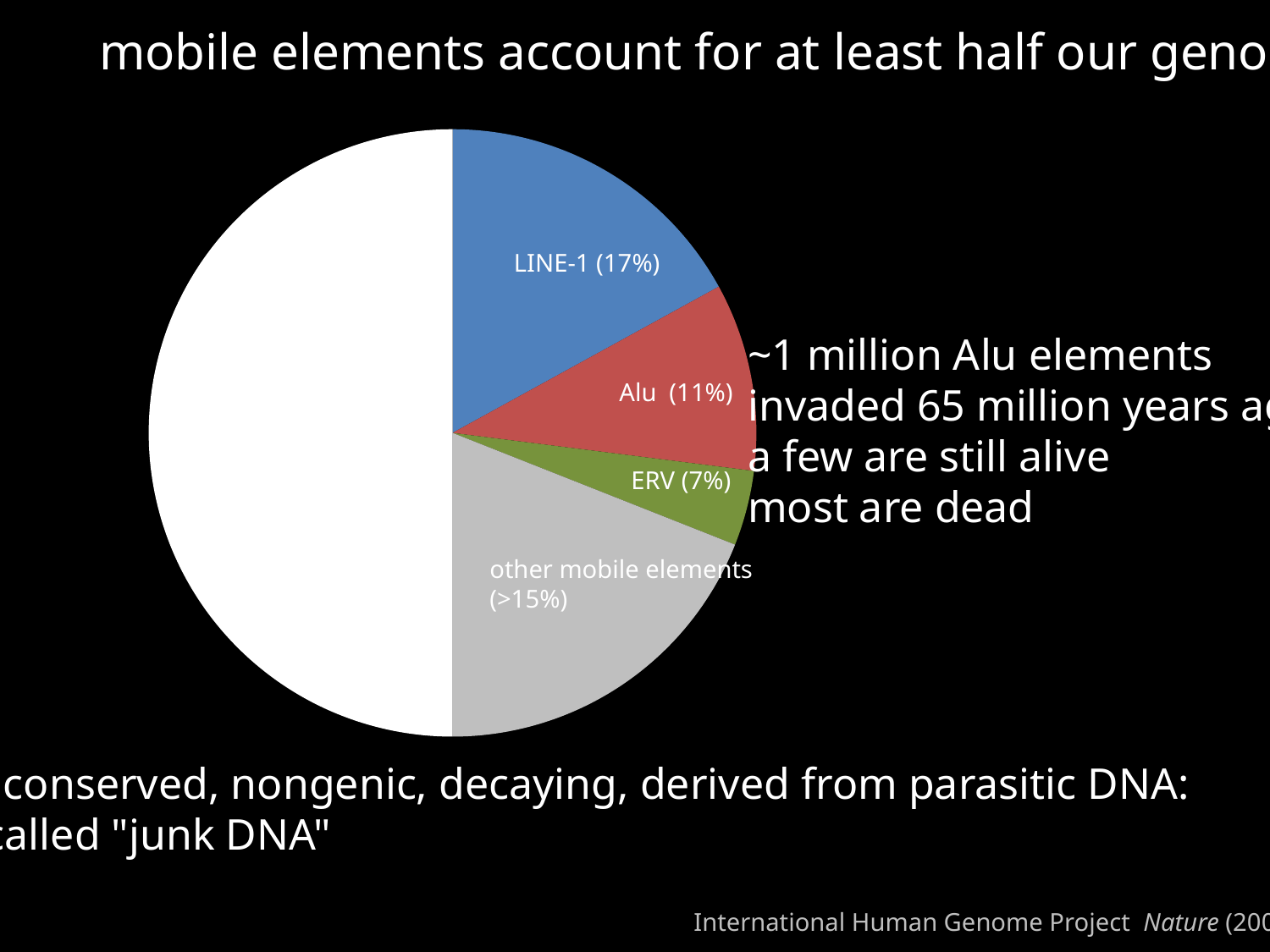
How many slices of the pie chart have a text label? 4 What percentage is given for other mobile elements in the pie chart? >15% Among LINE-1, Alu and ERV, which slice has the smallest percentage? ERV Which is larger, the LINE-1 slice or the Alu slice? LINE-1 What colour is the LINE-1 slice in the pie chart? blue By how many percentage points does Alu exceed ERV? 4 What percentage is shown for Alu in the pie chart? 11% What percentage is shown for ERV in the pie chart? 7% What percentage of the genome is attributed to LINE-1 in the pie chart? 17% Among LINE-1, Alu and ERV, which slice has the largest percentage? LINE-1 By how many percentage points does LINE-1 exceed Alu? 6 What kind of chart is shown on the slide? pie chart